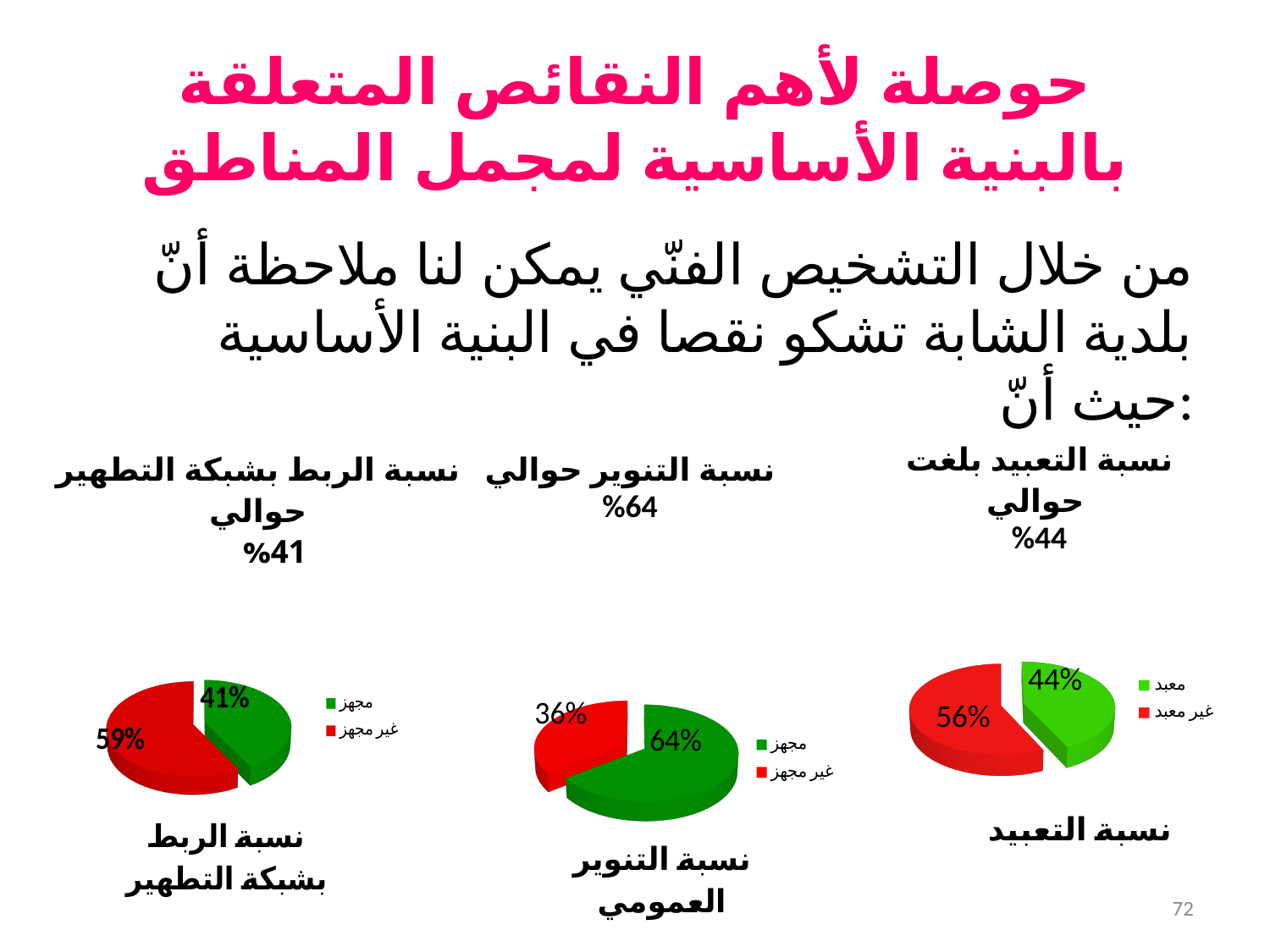
In the chart titled نسبة الربط بشبكة التطهير, which slice is the smallest? مجهز In the chart titled نسبة التعبيد, what share of the pie is غير معبد? 56% In the chart titled نسبة التعبيد, which slice is larger, معبد or غير معبد? غير معبد In the chart titled نسبة الربط بشبكة التطهير, what is the value for غير مجهز? 59% In the chart titled نسبة الربط بشبكة التطهير, what is the value for مجهز? 41% In the chart titled نسبة التنوير العمومي, what is the value for مجهز? 64% In the chart titled نسبة التنوير العمومي, what is the value for غير مجهز? 36% In the chart titled نسبة التنوير العمومي, which slice is the largest? مجهز In the chart titled نسبة التنوير العمومي, what is the difference between the مجهز and غير مجهز slices? 28% How many slices does the chart titled نسبة الربط بشبكة التطهير have? 2 What type of chart is the chart titled نسبة التعبيد? Pie chart In the chart titled نسبة التعبيد, what share of the pie is معبد? 44%